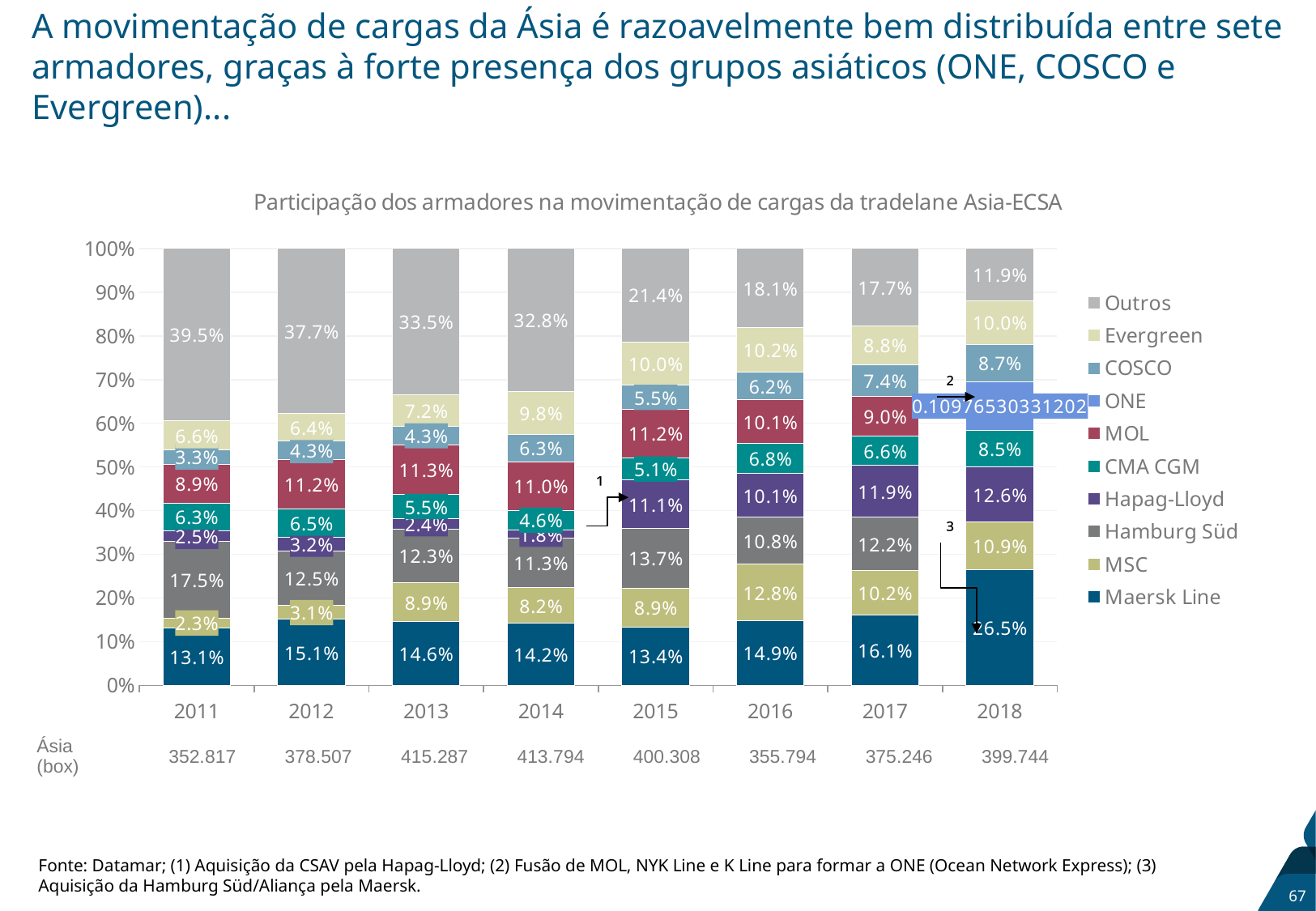
What is the share of Maersk Line in 2018? 26.5% How many years are shown on the x axis? 8 What kind of chart is shown? Stacked bar chart In which year is the Maersk Line share the highest? 2018 What is the share of MOL in 2015? 11.2% What is the share of Outros in 2011? 39.5% Which year has the larger Hamburg Süd share, 2011 or 2012? 2011 In which year is the Maersk Line share the lowest? 2011 By how many percentage points did the Maersk Line share increase from 2017 to 2018? 10.4 percentage points What is the share of Hapag-Lloyd in 2017? 11.9% How many series does the legend list? 10 Does the share of Outros rise or fall from 2011 to 2018? Fall